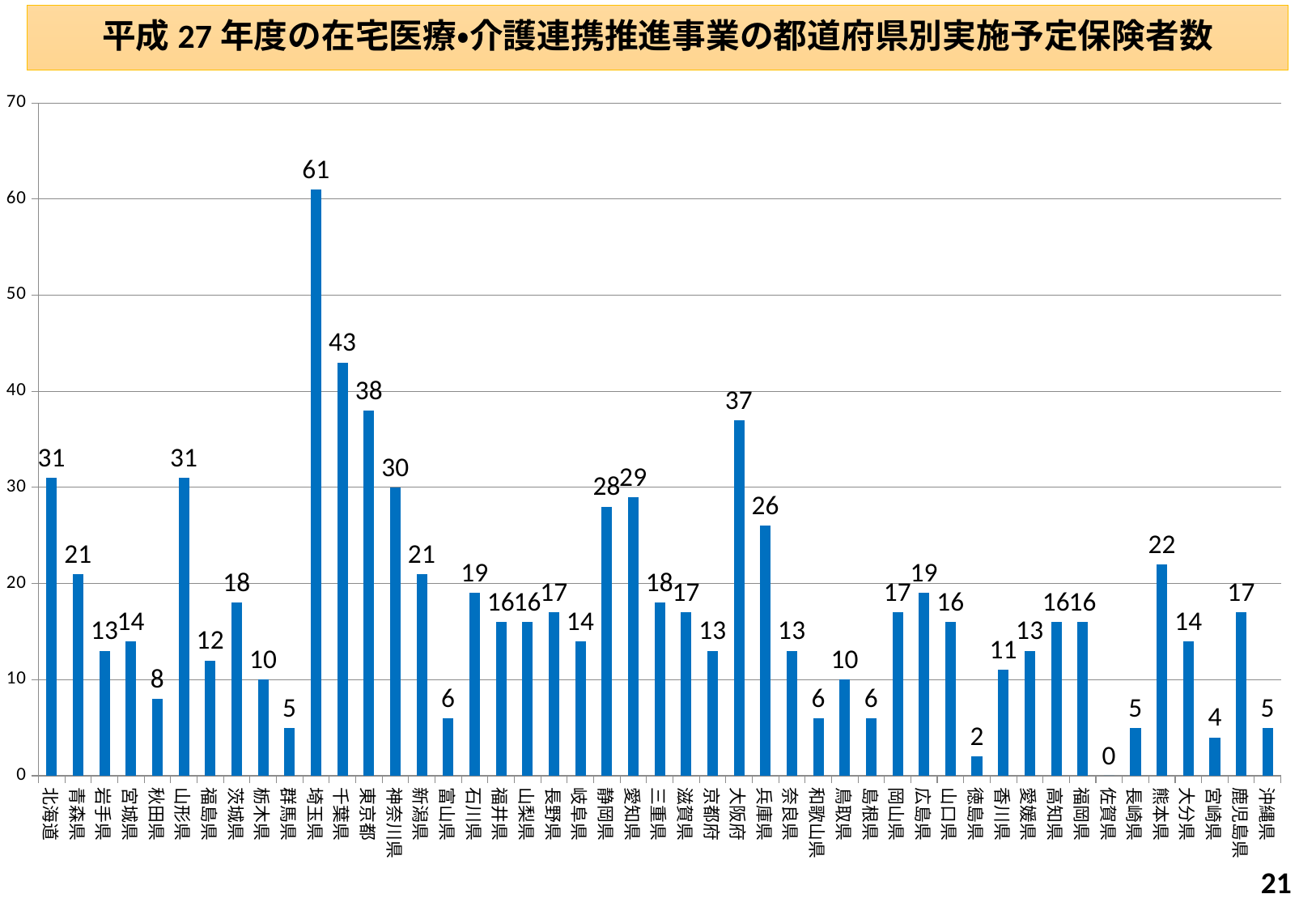
What kind of chart is this? bar chart What is the difference between the values for 千葉県 and 東京都? 5 How many prefectures are shown on the x axis? 47 What is the value for 熊本県? 22 Which prefecture has the lowest value? 佐賀県 What is the value for 佐賀県? 0 Which prefecture has the highest value? 埼玉県 What is the value for 埼玉県? 61 What is the title of the chart? 平成27年度の在宅医療・介護連携推進事業の都道府県別実施予定保険者数 Which is larger, the value for 北海道 or the value for 青森県? 北海道 Is the value for 神奈川県 greater or less than 20? greater What is the value for 大阪府? 37